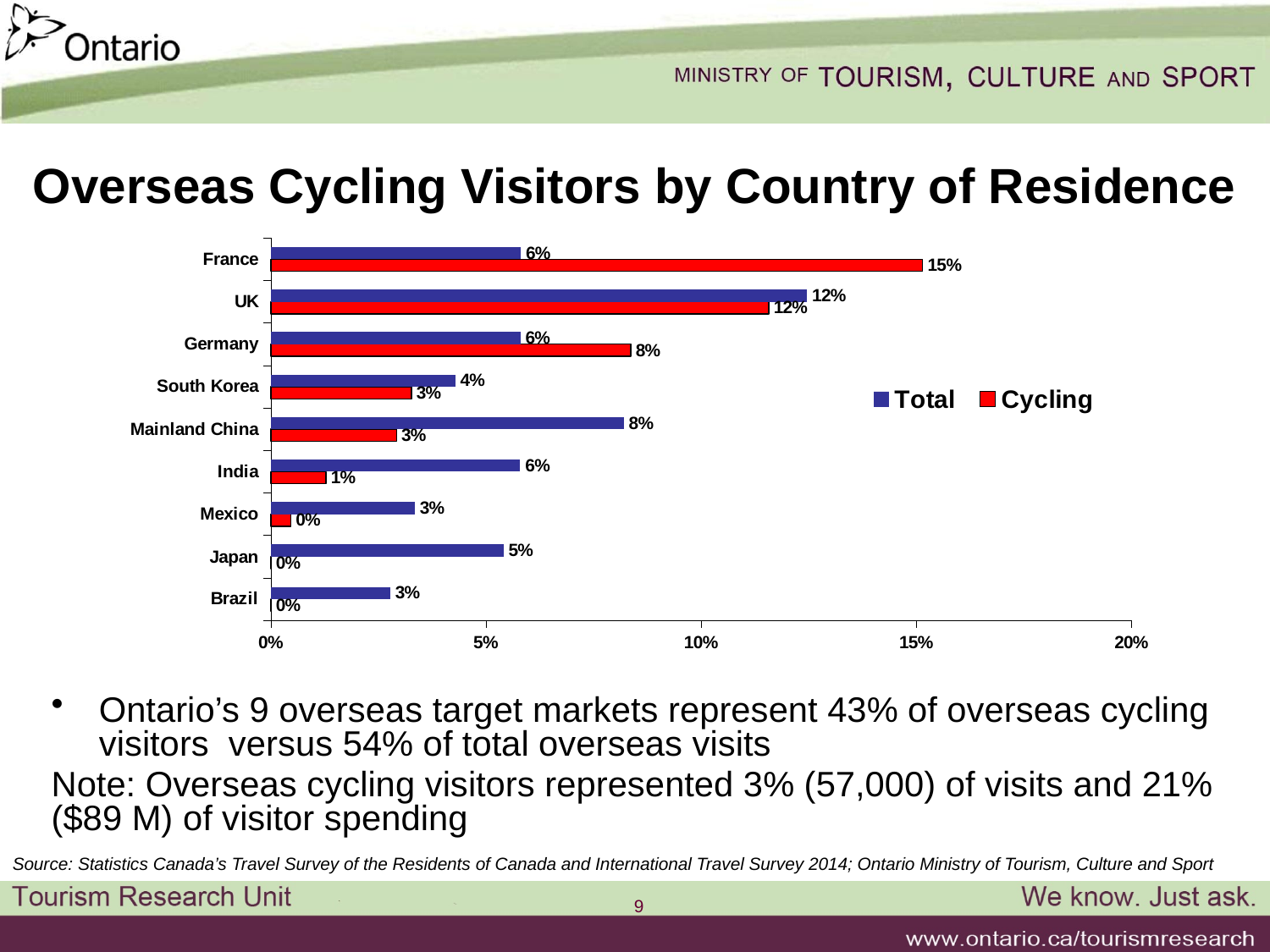
What kind of chart is shown on the slide? Bar chart Which country has the highest Total value? UK Which country has the highest Cycling value? France How many series does the legend list? 2 What is the Cycling value for France? 15% Is the Cycling value for France greater or less than 10%? greater What is the difference between the Total and Cycling values for Mainland China? 5 percentage points For Germany, which is larger, the Total value or the Cycling value? Cycling What is the difference between the Cycling and Total values for France? 9 percentage points What is the Total value for Mainland China? 8% What is the Cycling value for India? 1% How many countries are shown on the chart? 9